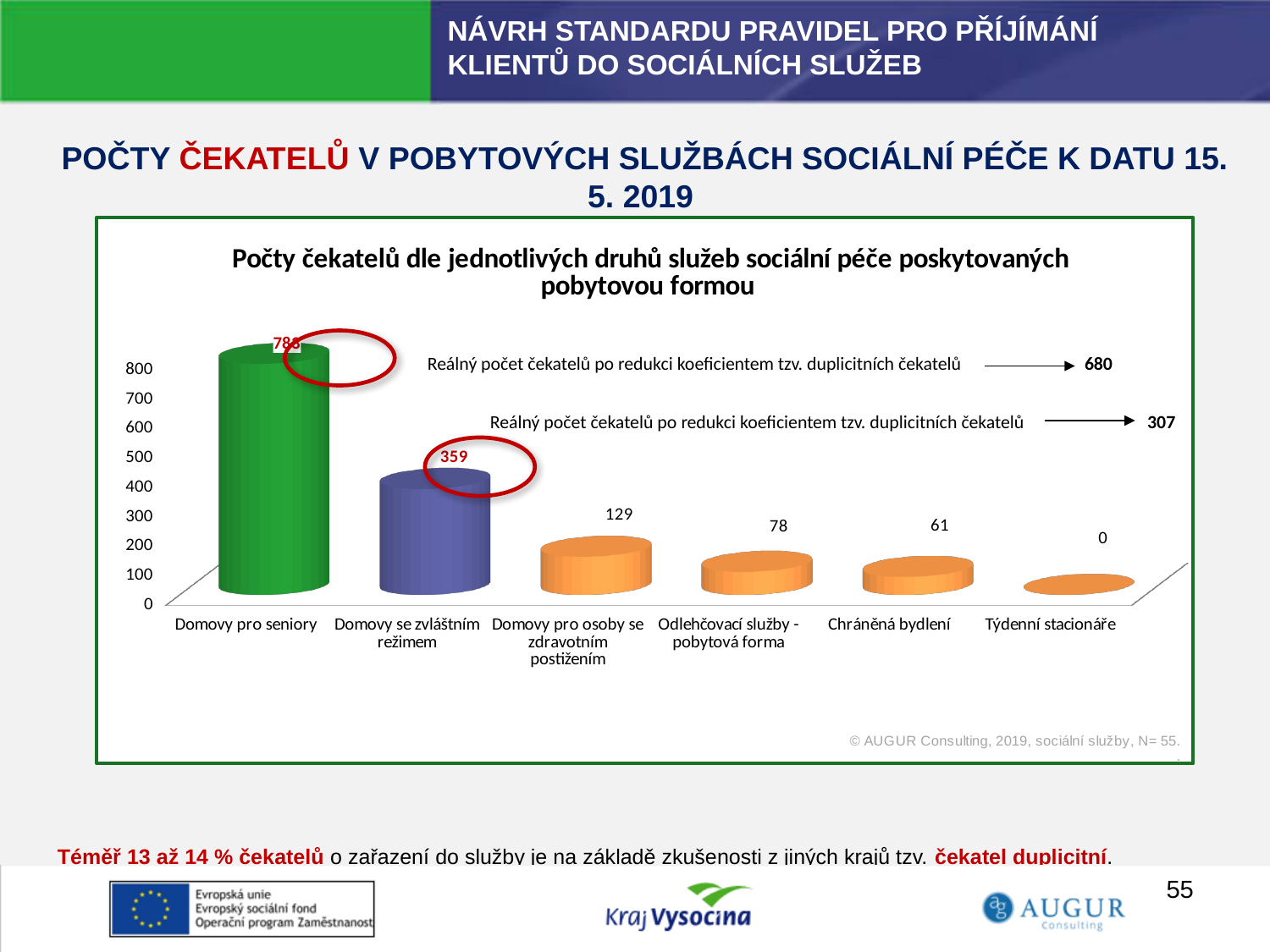
Which category has the highest value? Domovy pro seniory What is the difference between the values for Domovy se zvláštním režimem and Domovy pro osoby se zdravotním postižením? 230 Which category has the lowest value? Týdenní stacionáře What is the value for Domovy pro osoby se zdravotním postižením? 129 Is the value for Domovy pro seniory greater or less than 700? greater What is the value for Odlehčovací služby - pobytová forma? 78 Which is larger, the value for Odlehčovací služby - pobytová forma or the value for Chráněná bydlení? Odlehčovací služby - pobytová forma What is the value for Domovy se zvláštním režimem? 359 What is the value for Týdenní stacionáře? 0 What kind of chart is shown? bar chart How many categories are shown on the x axis? 6 What is the value for Chráněná bydlení? 61